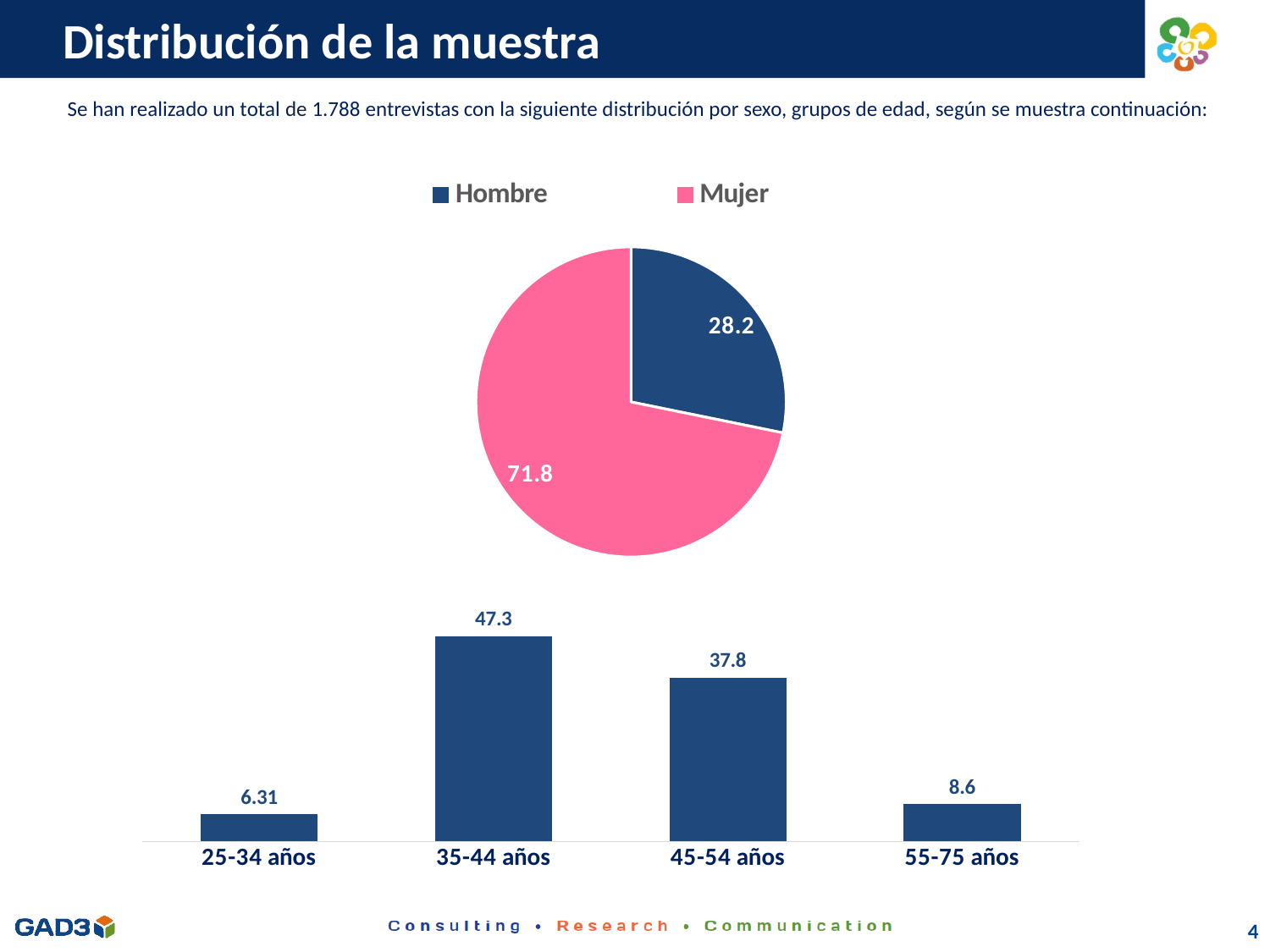
In the bar chart at the bottom of the slide, which age group has the lowest value? 25-34 años How many series does the legend of the pie chart at the top of the slide list? 2 In the bar chart at the bottom of the slide, what is the value for 35-44 años? 47.3 In the pie chart at the top of the slide, what value is shown for Mujer? 71.8 In the pie chart at the top of the slide, which slice is larger, Hombre or Mujer? Mujer In the bar chart at the bottom of the slide, which age group has the highest value? 35-44 años How many age groups are shown in the bar chart at the bottom of the slide? 4 What type of chart is the chart at the bottom of the slide? Bar chart In the pie chart at the top of the slide, what value is shown for Hombre? 28.2 In the bar chart at the bottom of the slide, what is the difference between the values for 35-44 años and 45-54 años? 9.5 In the pie chart at the top of the slide, what is the difference between the Mujer and Hombre values? 43.6 In the bar chart at the bottom of the slide, what is the value for 25-34 años? 6.31